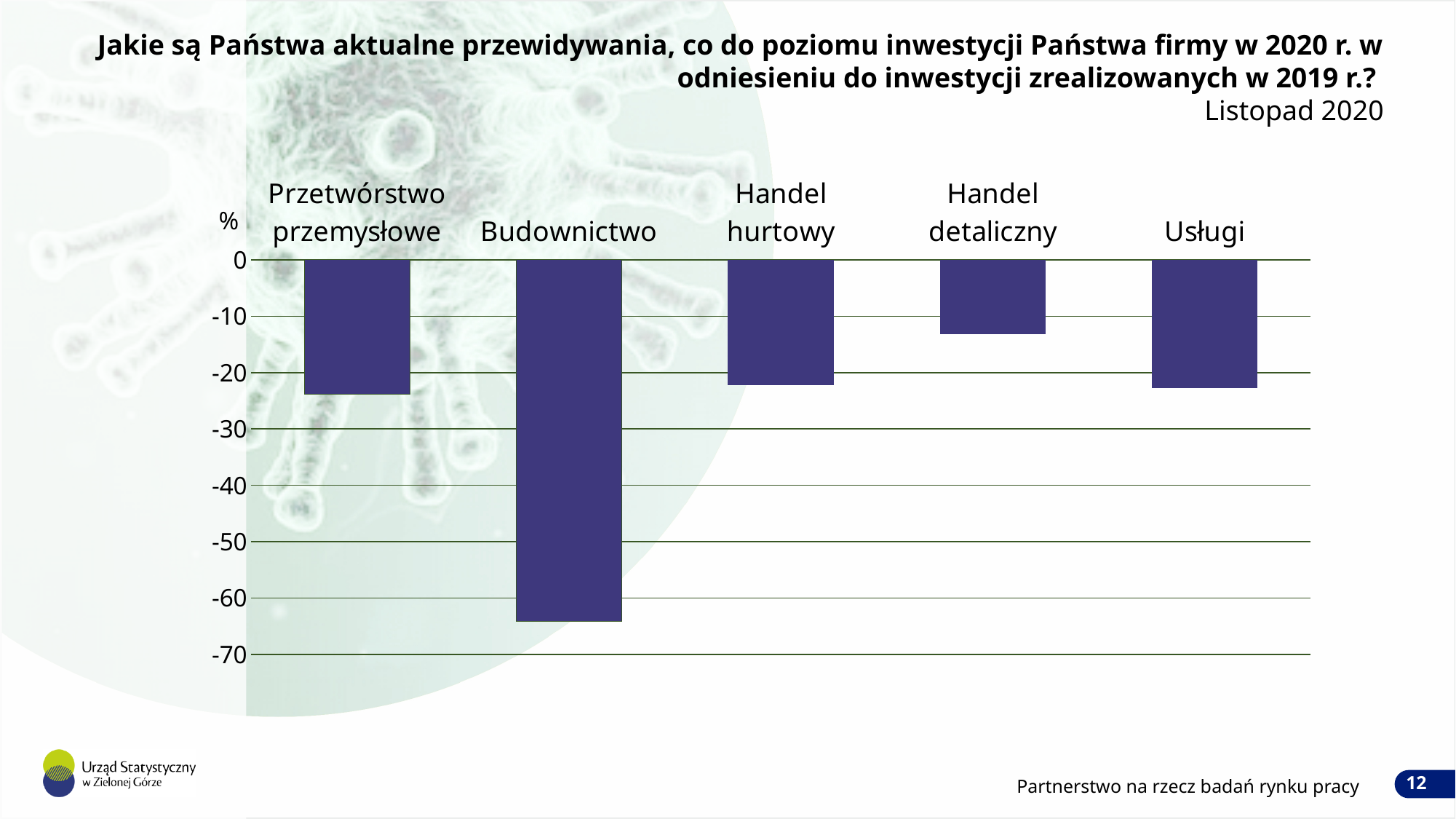
Is the value for Usługi greater or less than -30? greater Is the value for Handel detaliczny greater or less than -20? greater What kind of chart is shown on the slide? bar chart How many categories (sectors) are plotted in the chart? 5 Is the value for Przetwórstwo przemysłowe greater or less than -20? less Which category has the lowest (most negative) value? Budownictwo Which category has the highest value (closest to zero)? Handel detaliczny What unit is shown on the vertical axis of the chart? % Which has the larger value, Handel detaliczny or Przetwórstwo przemysłowe? Handel detaliczny Which has the larger value, Budownictwo or Usługi? Usługi